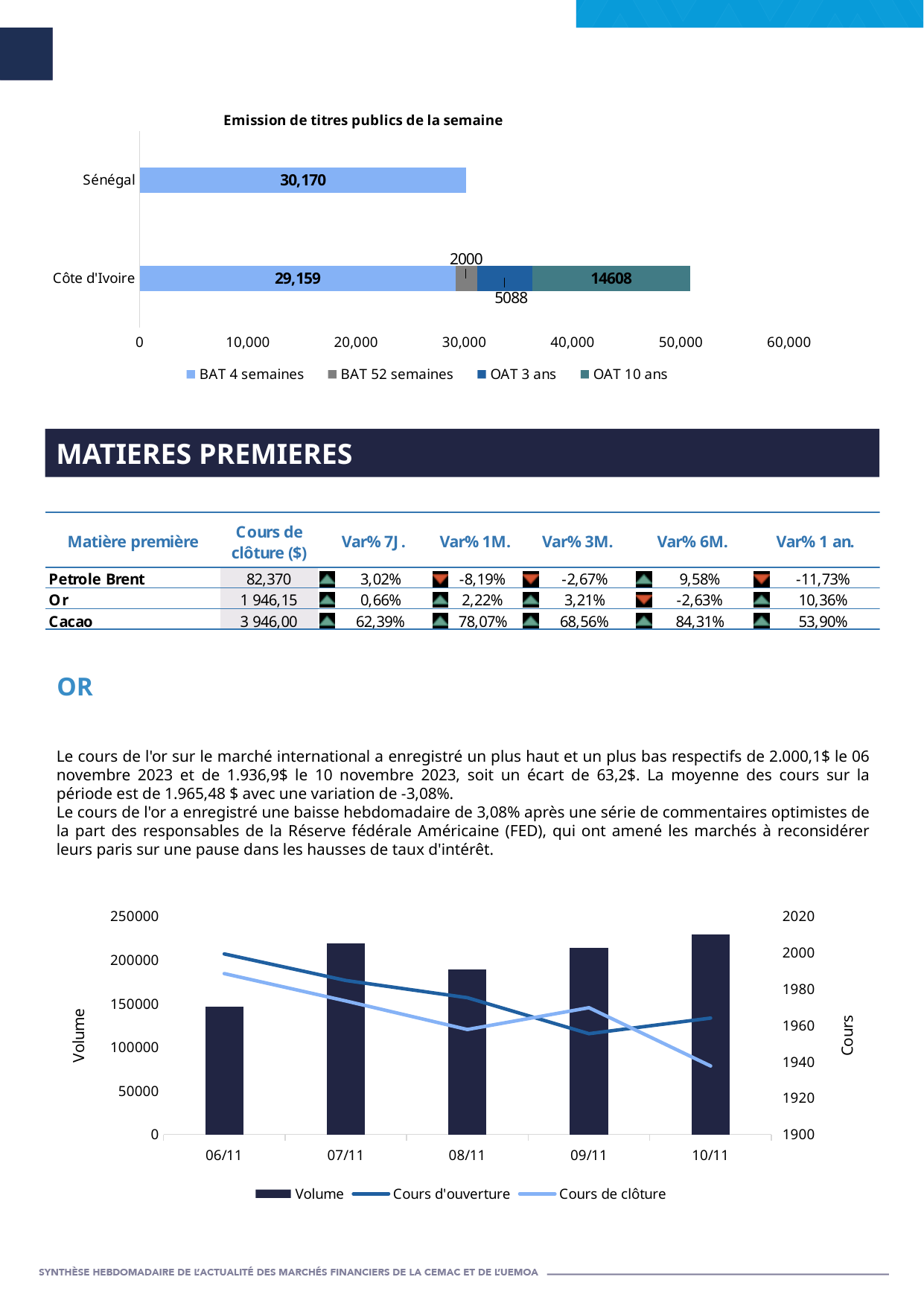
In the chart 'Emission de titres publics de la semaine', what is the value of OAT 10 ans for Côte d'Ivoire? 14608 In the chart 'Emission de titres publics de la semaine', how many countries are shown? 2 In the bottom chart (gold volume and price), how many series does the legend list? 3 In the chart 'Emission de titres publics de la semaine', what is the difference between the BAT 4 semaines values of Sénégal and Côte d'Ivoire? 1,011 In the bottom chart (gold volume and price), on which date is the Volume bar highest? 10/11 In the chart 'Emission de titres publics de la semaine', what is the value of OAT 3 ans for Côte d'Ivoire? 5088 In the chart 'Emission de titres publics de la semaine', what is the value of BAT 52 semaines for Côte d'Ivoire? 2000 In the bottom chart (gold volume and price), is the Volume on 08/11 greater or less than 200000? less In the chart 'Emission de titres publics de la semaine', which country has the larger BAT 4 semaines value, Sénégal or Côte d'Ivoire? Sénégal In the bottom chart (gold volume and price), on which date is the Volume bar lowest? 06/11 In the chart 'Emission de titres publics de la semaine', what is the value of BAT 4 semaines for Sénégal? 30,170 In the chart 'Emission de titres publics de la semaine', how many series does the legend list? 4